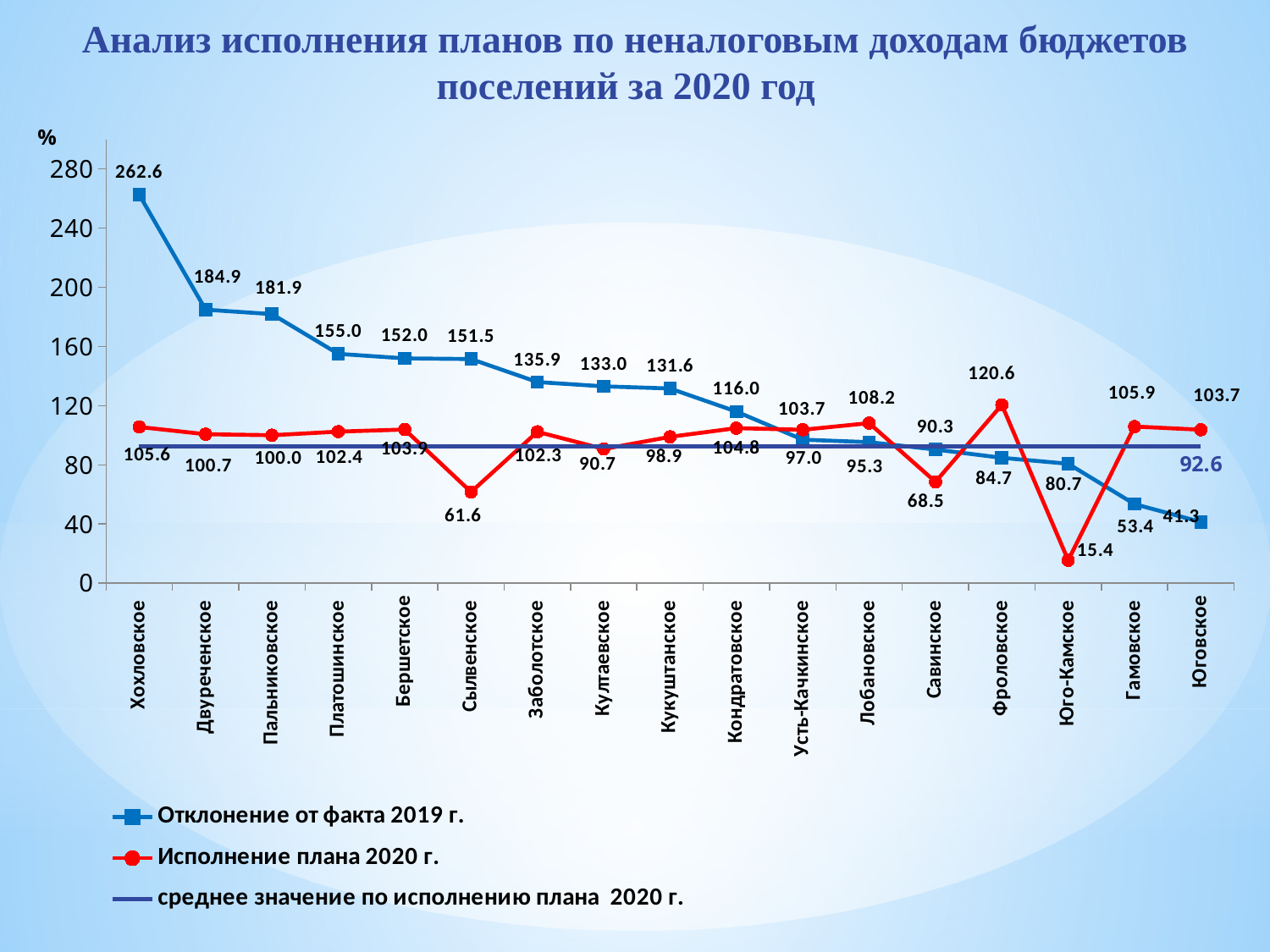
How many settlements are plotted along the x axis? 17 Which settlement has the lowest value of "Отклонение от факта 2019 г."? Юговское What is the difference between the "Отклонение от факта 2019 г." values for Двуреченское and Пальниковское? 3.0 Does the "Отклонение от факта 2019 г." series rise or fall from left to right along the x axis? Fall What is the value of the line "среднее значение по исполнению плана 2020 г."? 92.6 What is the value of "Отклонение от факта 2019 г." for Хохловское? 262.6 How many series does the legend list? 3 Which settlement has the lowest value of "Исполнение плана 2020 г."? Юго-Камское Which is larger for Савинское: "Отклонение от факта 2019 г." or "Исполнение плана 2020 г."? Отклонение от факта 2019 г. What is the value of "Исполнение плана 2020 г." for Сылвенское? 61.6 Which settlement has the highest value of "Исполнение плана 2020 г."? Фроловское What kind of chart is shown on the slide? Line chart